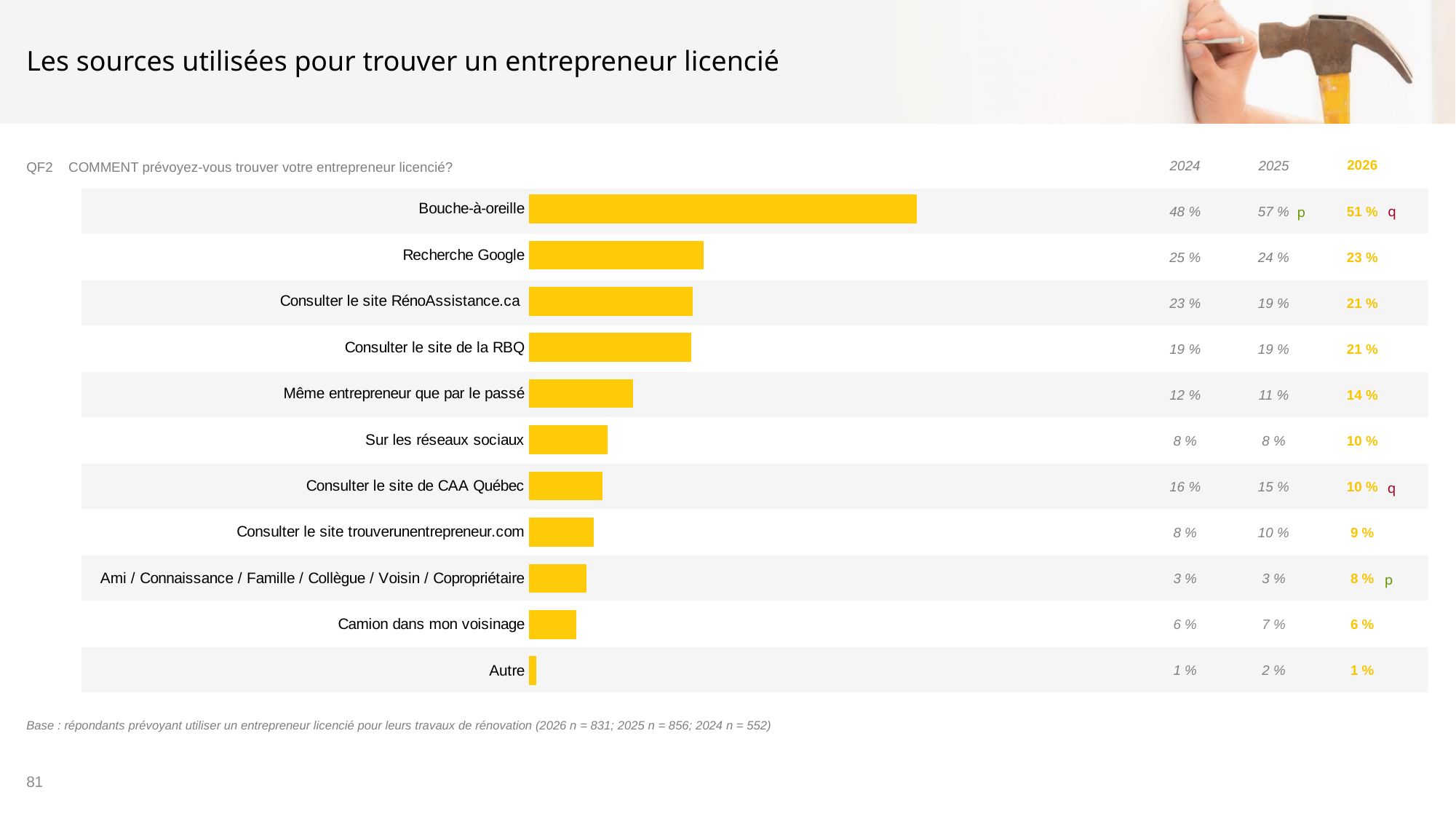
What is the 2024 value for Consulter le site de CAA Québec? 16 % What is the difference between the 2026 values for Recherche Google and Camion dans mon voisinage? 17 % What is the 2025 value for Consulter le site trouverunentrepreneur.com? 10 % Which has the larger 2026 value, Recherche Google or Même entrepreneur que par le passé? Recherche Google Which category has the highest 2026 value? Bouche-à-oreille How many categories are shown in the chart? 11 Which category has the lowest 2026 value? Autre What kind of chart is shown on the slide? Bar chart What colour are the bars in the chart? Yellow How many years of data are listed in the table next to the bars? 3 What is the 2026 value for Bouche-à-oreille? 51 % What is the difference between the 2025 and 2026 values for Bouche-à-oreille? 6 %